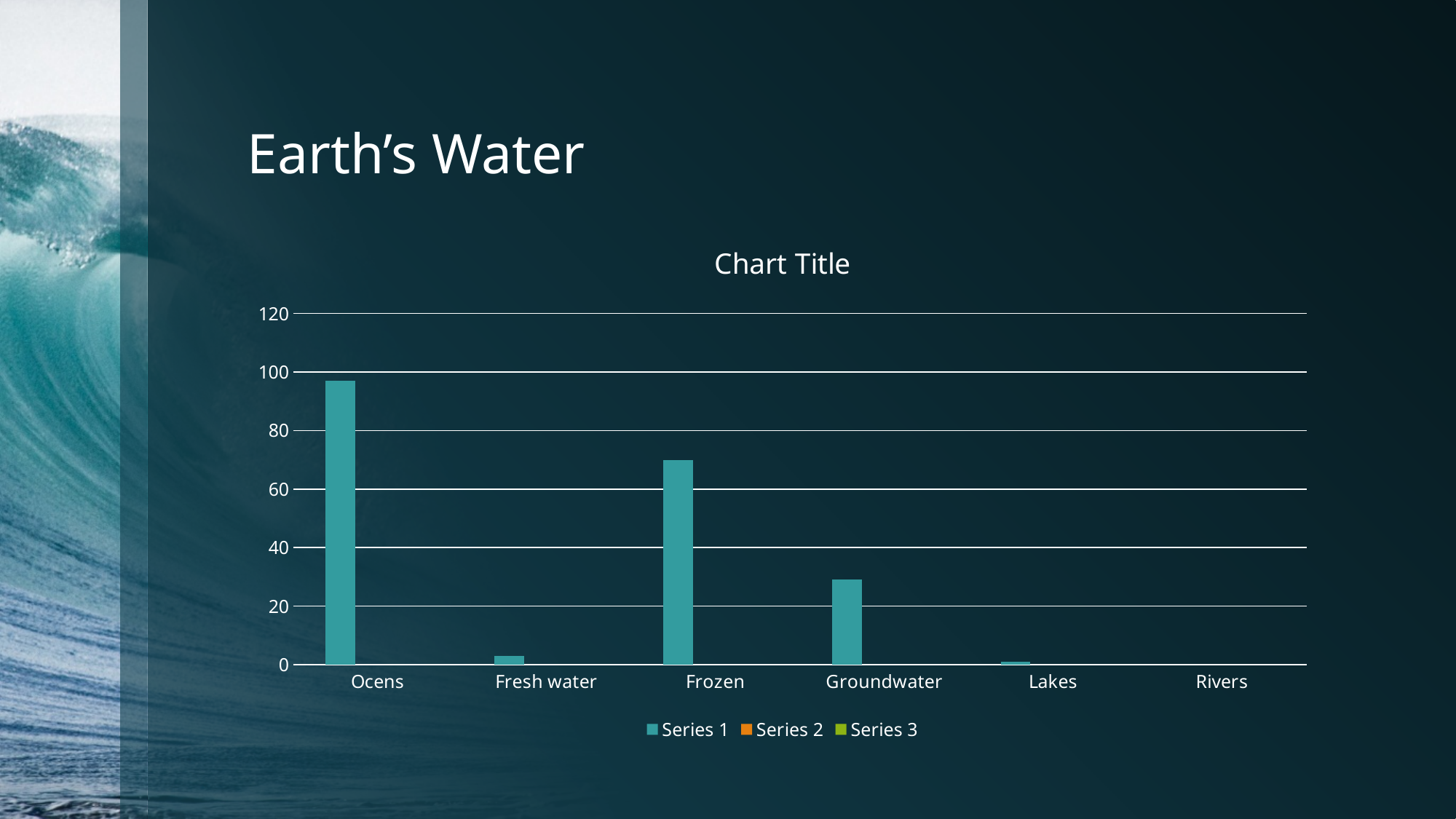
Is the value for Frozen greater or less than 80? less How many series does the chart legend list? 3 Is the value for Fresh water greater or less than 20? less Which is larger, the value for Frozen or the value for Groundwater? Frozen Is the value for Frozen greater or less than 60? greater What is the title shown above the chart? Chart Title What is the name of the first series listed in the chart legend? Series 1 Which category has the highest bar in the chart? Ocens How many categories are shown on the x axis of the chart? 6 What type of chart is shown on the slide? Bar chart